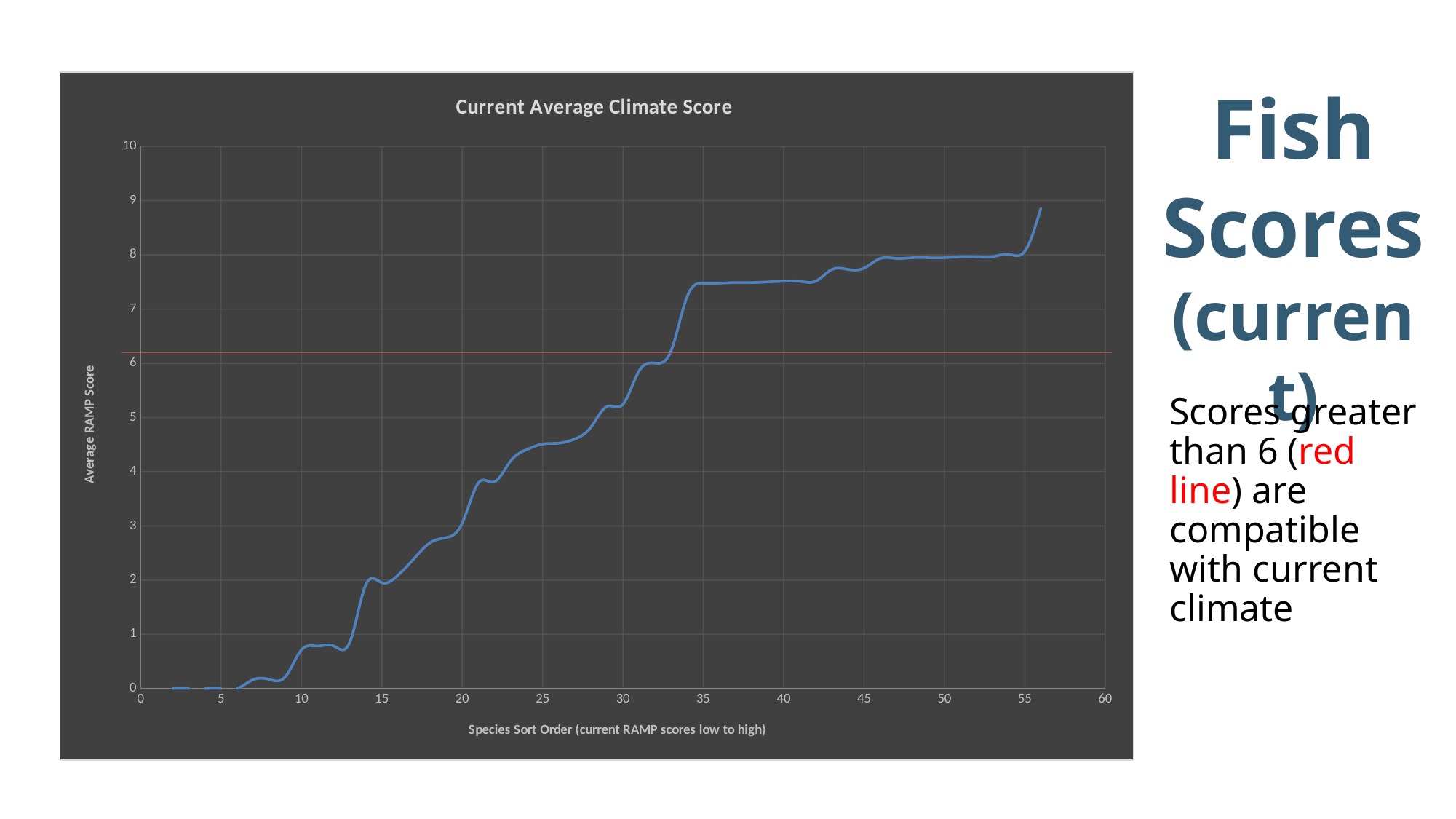
Do the plotted values rise or fall as the species sort order increases along the x axis? rise Is the value at species sort order 50 greater or less than 7? greater Is the value at species sort order 45 greater or less than 8? less Is the value at species sort order 25 greater or less than 5? less What is the title of the chart? Current Average Climate Score What kind of chart is shown on the slide? line chart What is the label of the vertical axis of the chart? Average RAMP Score